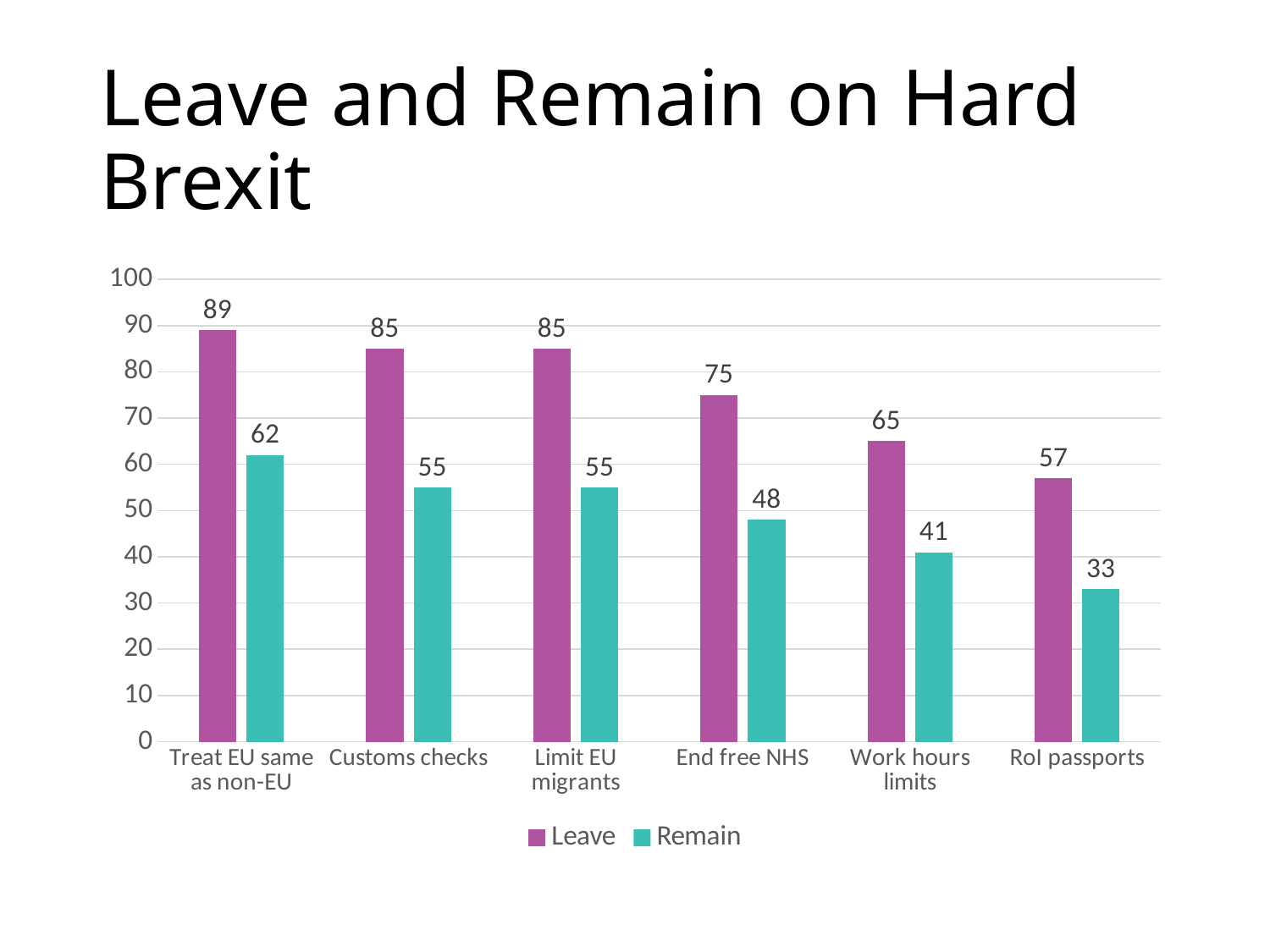
What kind of chart is shown on the slide? Bar chart Do the Leave values rise or fall from left to right along the x axis? Fall How many series does the legend list? 2 What is the Remain value for RoI passports? 33 What is the title of the slide? Leave and Remain on Hard Brexit What is the Remain value for End free NHS? 48 What is the difference between the Leave and Remain values for Work hours limits? 24 Which category has the highest Leave value? Treat EU same as non-EU What is the Leave value for Treat EU same as non-EU? 89 Which category has the lowest Remain value? RoI passports Which is larger: the Leave value for End free NHS or the Leave value for RoI passports? End free NHS How many categories are shown on the x axis? 6